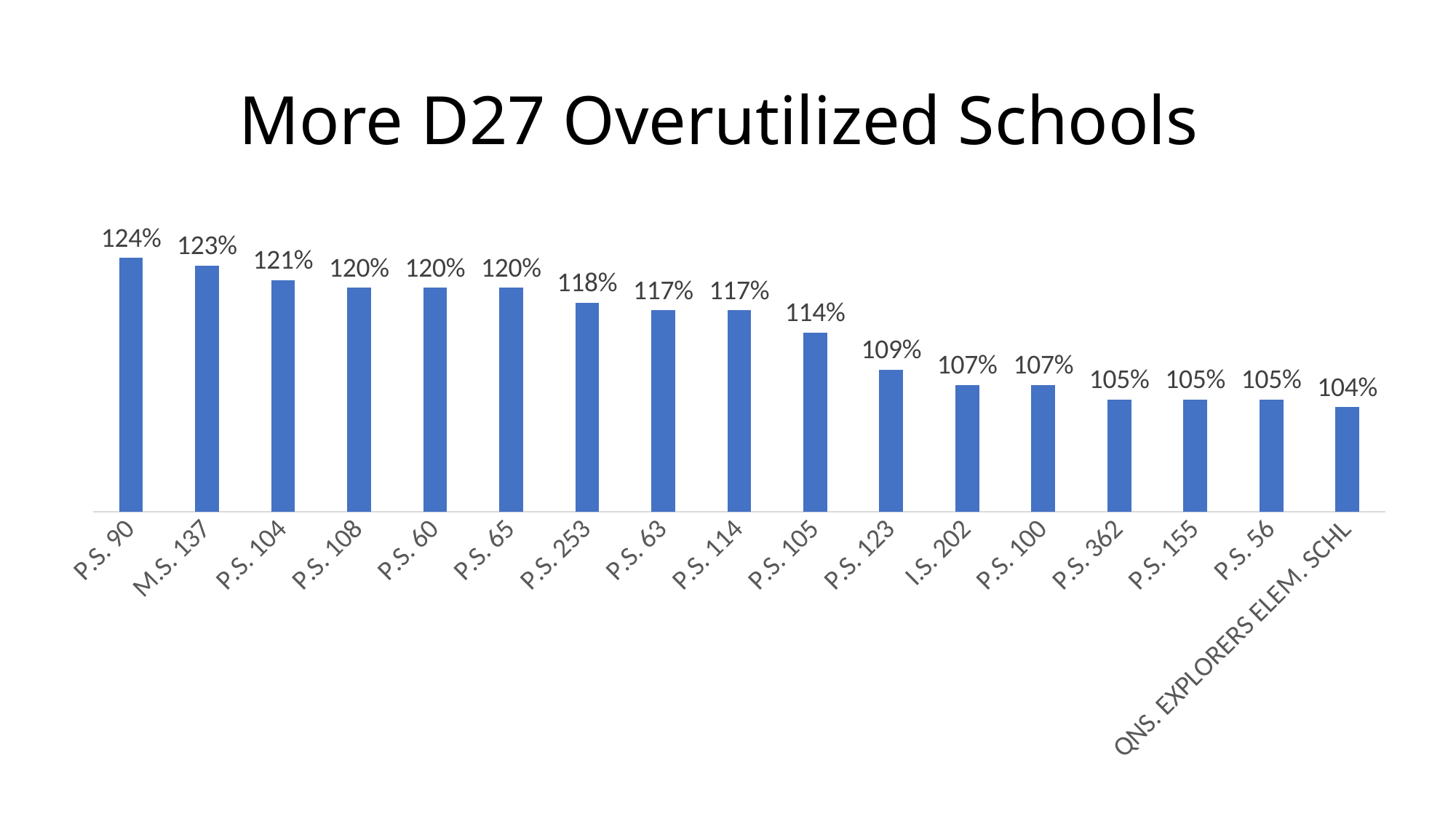
Which is larger, the value for P.S. 104 or the value for P.S. 63? P.S. 104 What is the value for I.S. 202? 107% Which school has the lowest value? QNS. EXPLORERS ELEM. SCHL Which school has the highest value? P.S. 90 What is the value for P.S. 90? 124% Do the values rise or fall from left to right along the x axis? Fall How many schools are shown in the chart? 17 What is the value for QNS. EXPLORERS ELEM. SCHL? 104% What is the value for P.S. 253? 118% What is the difference between the values for M.S. 137 and P.S. 123? 14% What is the difference between the values for P.S. 90 and P.S. 105? 10% What kind of chart is shown on the slide? Bar chart